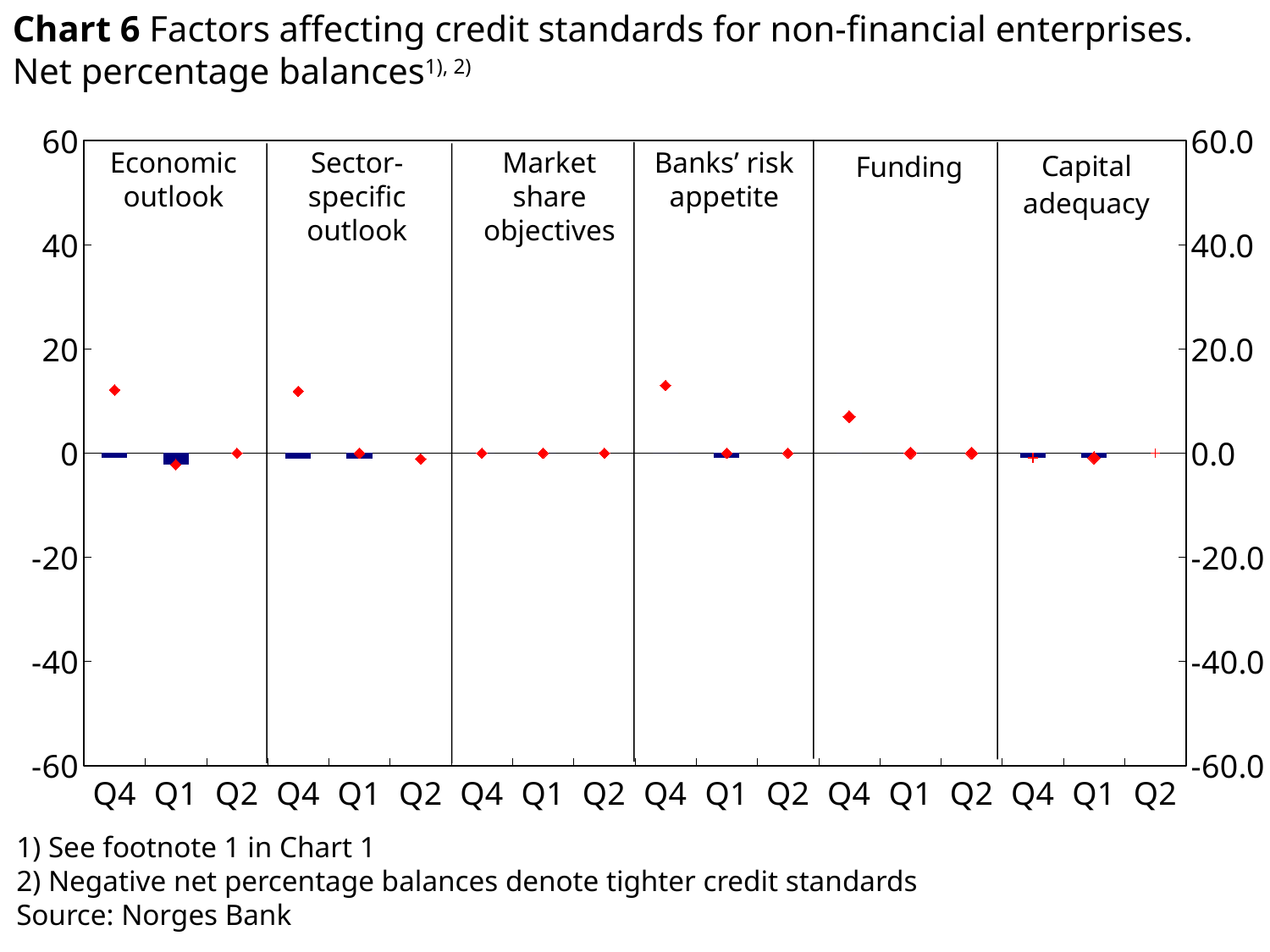
How many factor panels are shown in the chart? 6 What is the title of the chart? Chart 6 Factors affecting credit standards for non-financial enterprises. Net percentage balances Do the red diamond values under Banks' risk appetite rise or fall from Q4 to Q1? fall How many quarters are shown on the x axis within each factor panel? 3 Is the red diamond value for Q4 under Funding greater or less than 0? greater What is the source given for the chart? Norges Bank What kind of chart is this? combination bar and line chart (bars with diamond markers) Which is larger: the red diamond value for Q4 under Economic outlook or the red diamond value for Q4 under Funding? Q4 under Economic outlook Is the red diamond value for Q4 under Economic outlook greater or less than 0? greater Is the red diamond value for Q4 under Economic outlook greater or less than 20? less What is the maximum value shown on the left vertical axis? 60